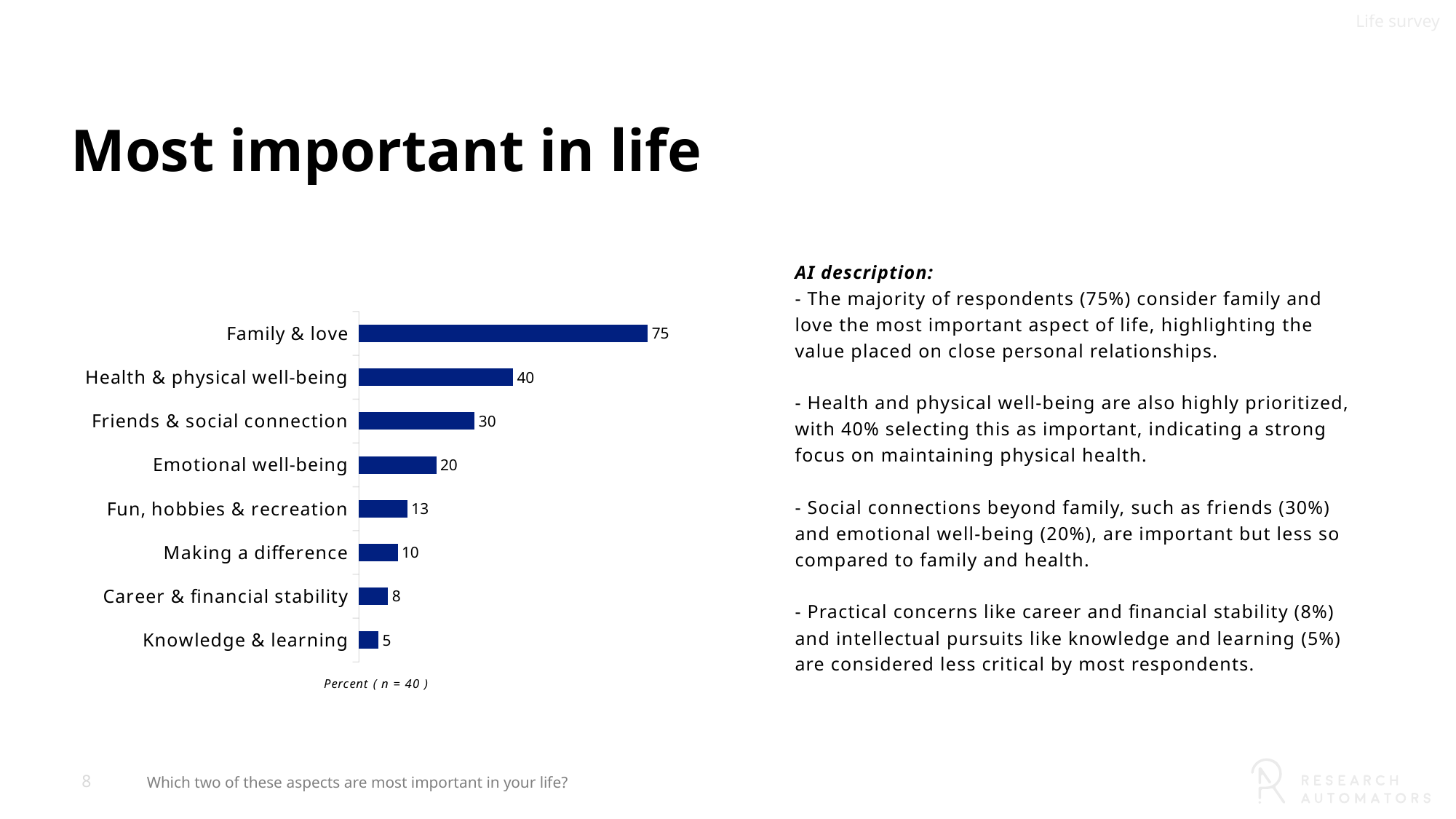
What is the difference between the values for Friends & social connection and Emotional well-being? 10 How many categories are shown in the chart? 8 What is the sample size noted below the chart? n = 40 What is the difference between the values for Family & love and Health & physical well-being? 35 What is the value for Family & love? 75 Which is larger, the value for Making a difference or the value for Career & financial stability? Making a difference What is the value for Fun, hobbies & recreation? 13 Which category has the lowest value? Knowledge & learning What is the value for Health & physical well-being? 40 Which category has the highest value? Family & love What is the value for Career & financial stability? 8 What kind of chart is shown on the slide? Bar chart